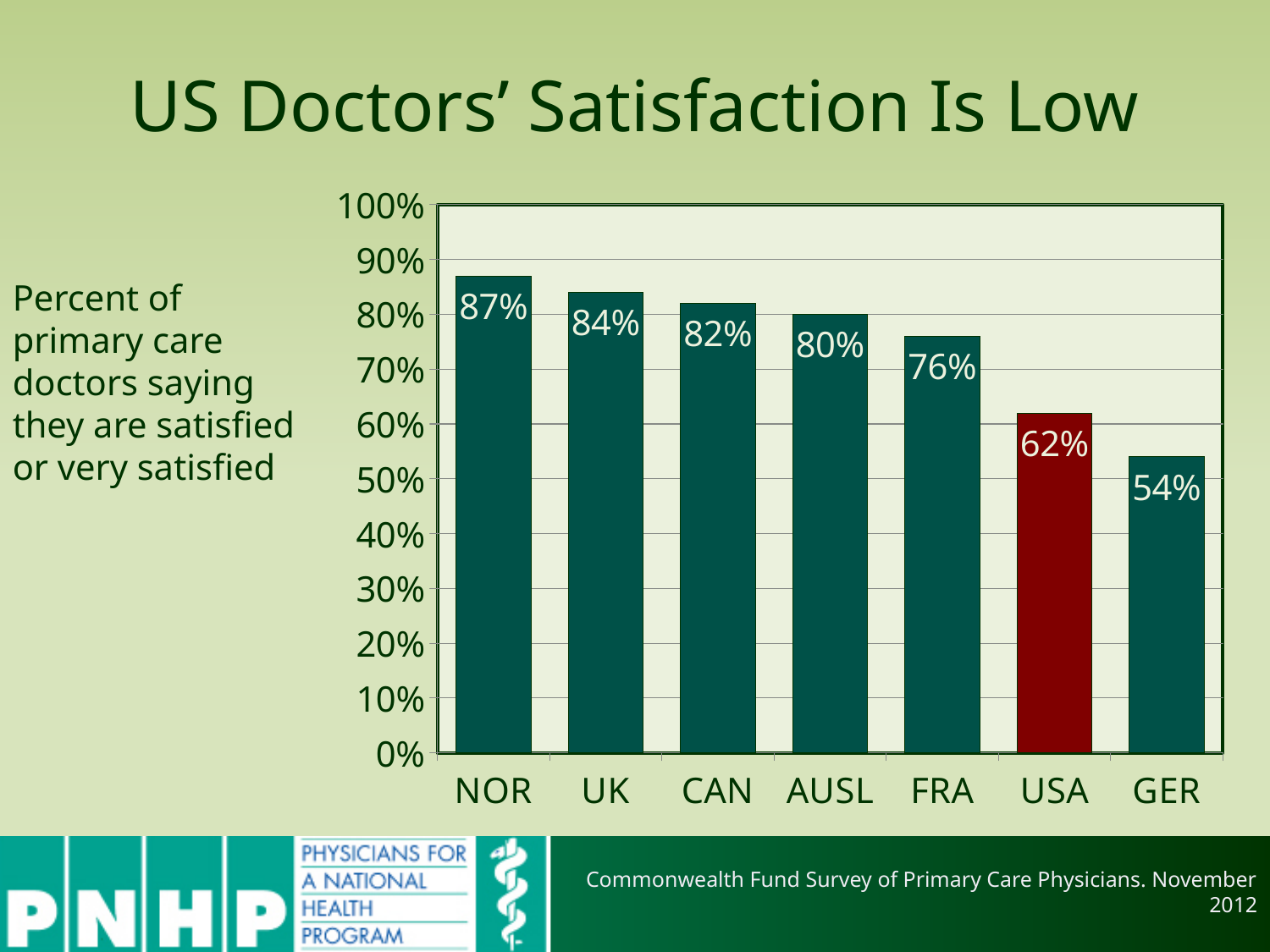
What is the difference between the values for UK and CAN? 2% What is the value shown for NOR? 87% How many countries are shown in the chart? 7 Which has a higher value, AUSL or USA? AUSL Which bar is coloured differently (dark red) from the others? USA Which country has the highest percentage of satisfied primary care doctors? NOR What is the value shown for FRA? 76% What is the difference between the values for NOR and USA? 25% Is the value for GER greater or less than 60%? less What percent of primary care doctors in the USA say they are satisfied or very satisfied? 62% Which country has the lowest percentage of satisfied primary care doctors? GER What kind of chart is shown on the slide? Bar chart